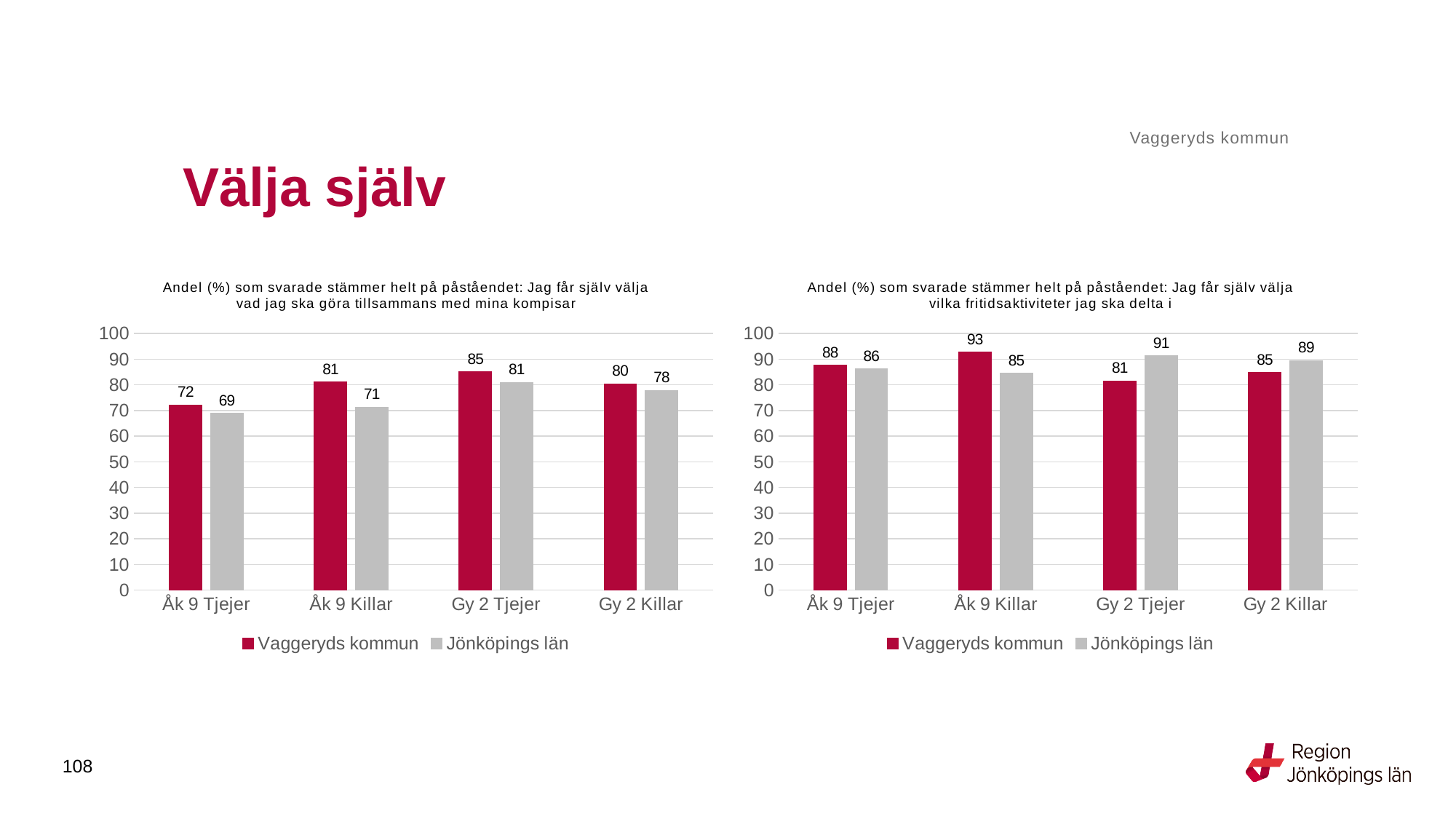
In the left chart (about choosing what to do with friends), what is the difference between Vaggeryds kommun and Jönköpings län for Åk 9 Killar? 10 How many categories are shown on the x axis of the left chart? 4 In the right chart (about choosing leisure activities), which category has the lowest value for Vaggeryds kommun? Gy 2 Tjejer In the right chart (about choosing leisure activities), which is larger for Gy 2 Killar: Vaggeryds kommun or Jönköpings län? Jönköpings län How many series does the legend of the right chart list? 2 In the left chart (about choosing what to do with friends), which category has the highest value for Vaggeryds kommun? Gy 2 Tjejer What kind of chart is the left chart? Bar chart In the right chart (about choosing leisure activities), what is the value for Jönköpings län for Gy 2 Tjejer? 91 In the left chart (about choosing what to do with friends), what is the value for Jönköpings län for Gy 2 Killar? 78 In the right chart (about choosing leisure activities), what is the value for Vaggeryds kommun for Åk 9 Killar? 93 In the left chart (about choosing what to do with friends), what is the value for Vaggeryds kommun for Åk 9 Tjejer? 72 In the right chart (about choosing leisure activities), what is the difference between Jönköpings län and Vaggeryds kommun for Gy 2 Tjejer? 10